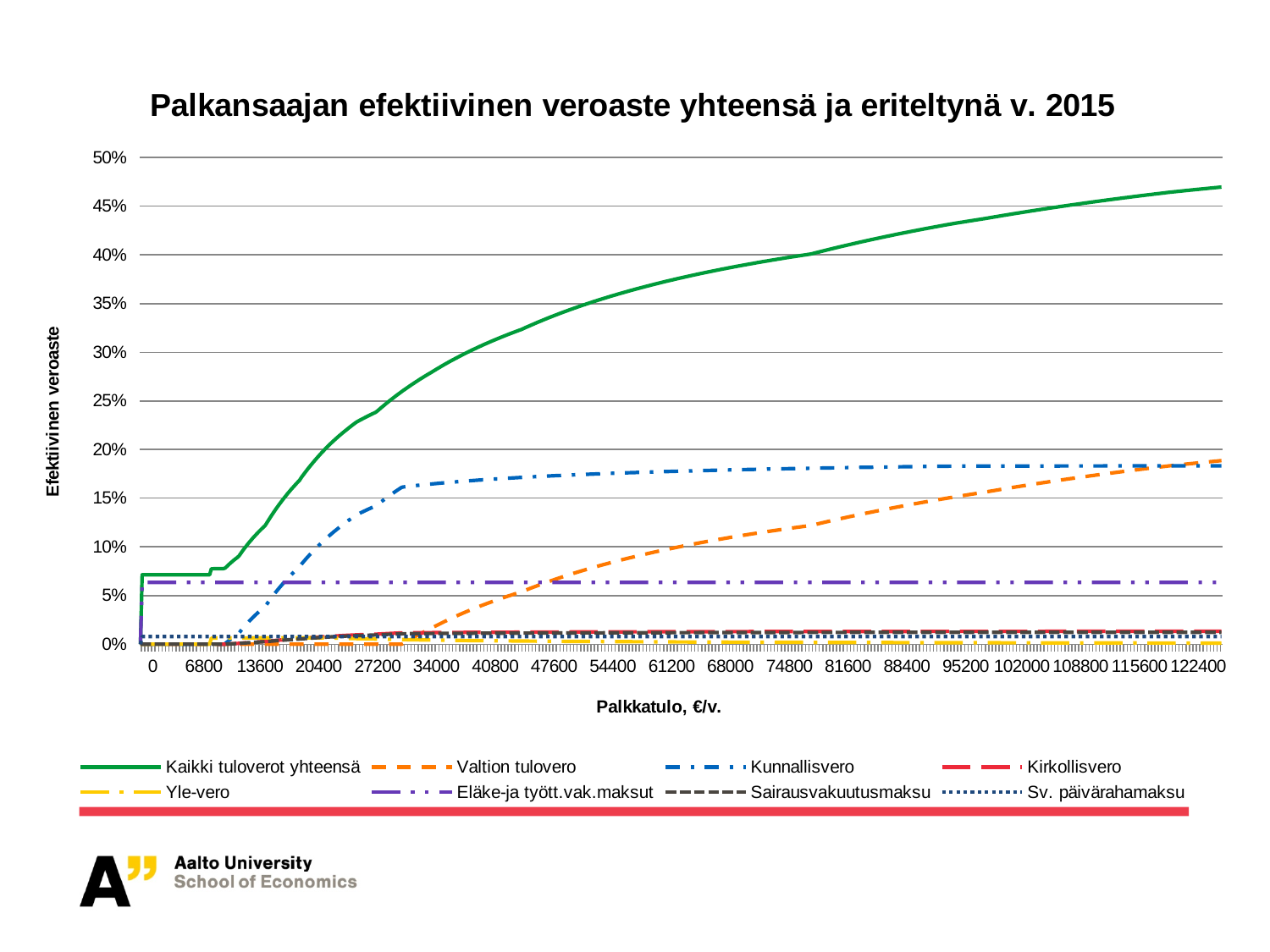
How many series does the legend list? 8 What kind of chart is shown on the slide? line chart Which series has the highest value at 122400? Kaikki tuloverot yhteensä At 40800, which is larger: Kunnallisvero or Valtion tulovero? Kunnallisvero Is the value of Kunnallisvero at 122400 greater or less than 15%? greater Which series has the lowest value at 122400? Yle-vero What is the title of the chart? Palkansaajan efektiivinen veroaste yhteensä ja eriteltynä v. 2015 Is the value of Valtion tulovero at 27200 greater or less than 5%? less Does the Kaikki tuloverot yhteensä line rise or fall as Palkkatulo increases? rise What is the label of the x axis? Palkkatulo, €/v. Is the value of Kaikki tuloverot yhteensä at 122400 greater or less than 45%? greater